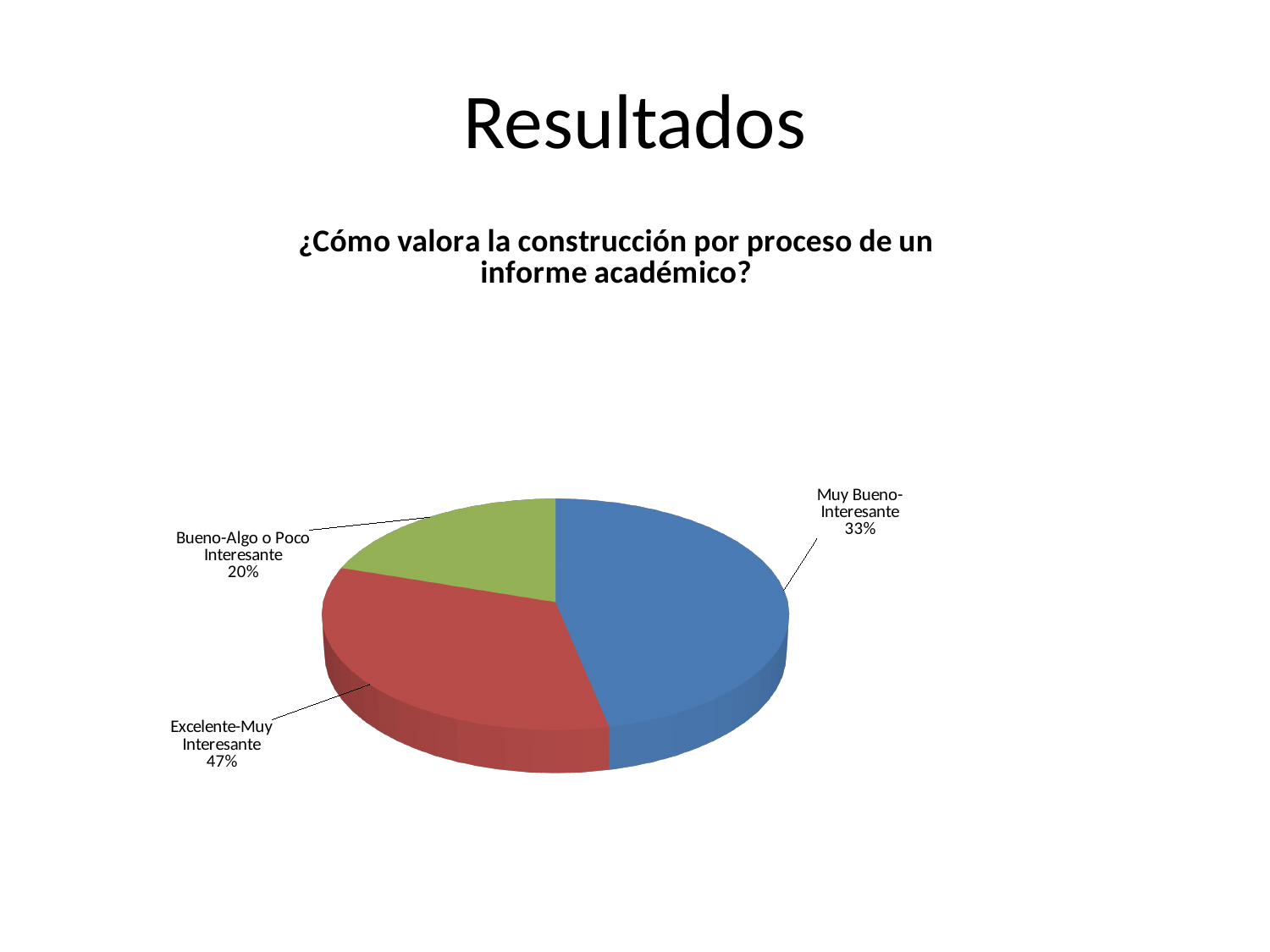
What share of the pie is labelled Muy Bueno-Interesante? 33% What is the difference in percentage points between Muy Bueno-Interesante and Bueno-Algo o Poco Interesante? 13% Which category has the smallest slice of the pie? Bueno-Algo o Poco Interesante Which category has the largest slice of the pie? Excelente-Muy Interesante What colour is the slice for Excelente-Muy Interesante? Red How many slices does the pie chart have? 3 Which is larger, the slice for Muy Bueno-Interesante or the slice for Bueno-Algo o Poco Interesante? Muy Bueno-Interesante What kind of chart is shown on the slide? Pie chart What share of the pie is labelled Bueno-Algo o Poco Interesante? 20% What is the chart's title? ¿Cómo valora la construcción por proceso de un informe académico? What is the difference in percentage points between Excelente-Muy Interesante and Muy Bueno-Interesante? 14% What share of the pie is labelled Excelente-Muy Interesante? 47%